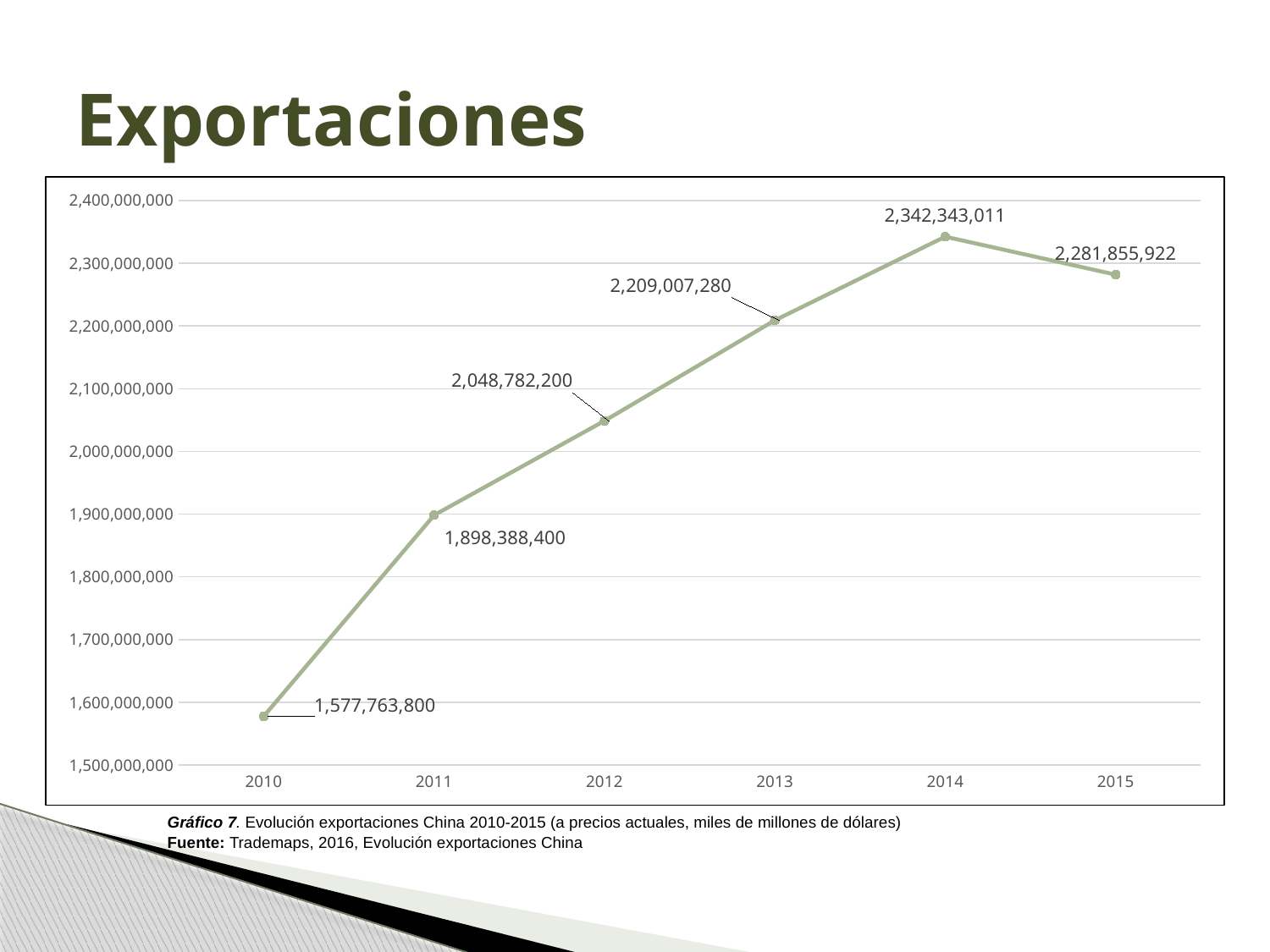
Which year has the highest export value? 2014 What is the export value shown for 2015? 2,281,855,922 What kind of chart is shown on the slide? Line chart Do the export values rise or fall from 2010 to 2014? Rise What is the difference between the export values for 2011 and 2010? 320,624,600 What is the export value shown for 2014? 2,342,343,011 How many years are plotted on the chart? 6 Which year has the lowest export value? 2010 Which year has a larger export value, 2013 or 2015? 2015 What is the export value shown for 2012? 2,048,782,200 What is the difference between the export values for 2014 and 2015? 60,487,089 What is the export value shown for 2010? 1,577,763,800